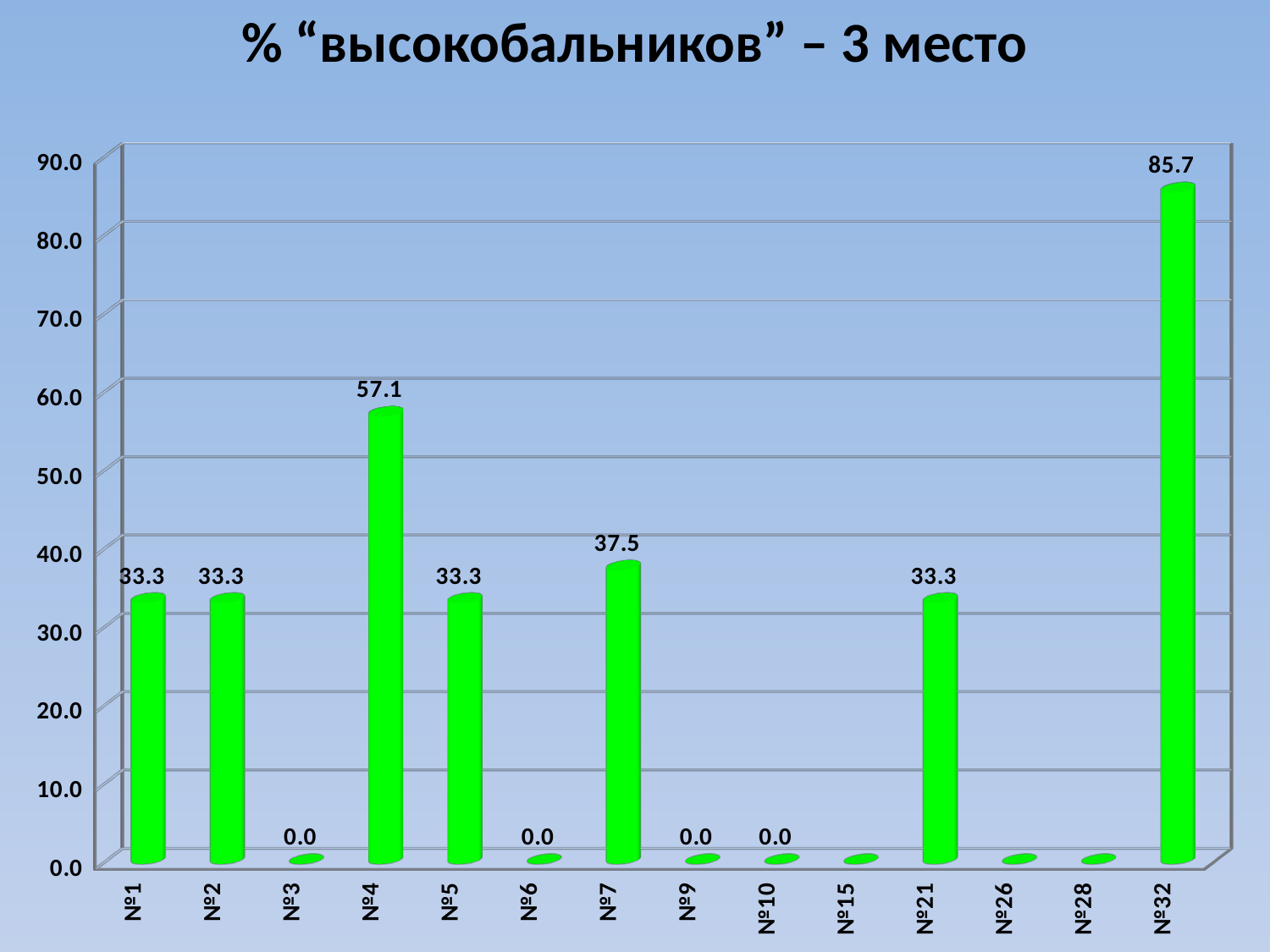
What is the difference between the values for №32 and №4? 28.6 What is the value for №21? 33.3 Which category has the highest value? №32 What is the value for №4? 57.1 How many categories are shown on the x axis? 14 What kind of chart is shown on the slide? bar chart How many categories have a printed data label of 0.0? 4 What is the difference between the values for №4 and №7? 19.6 What is the value for №32? 85.7 What is the value for №7? 37.5 Which is larger, the value for №7 or the value for №5? №7 Is the value for №4 greater or less than 50.0? greater